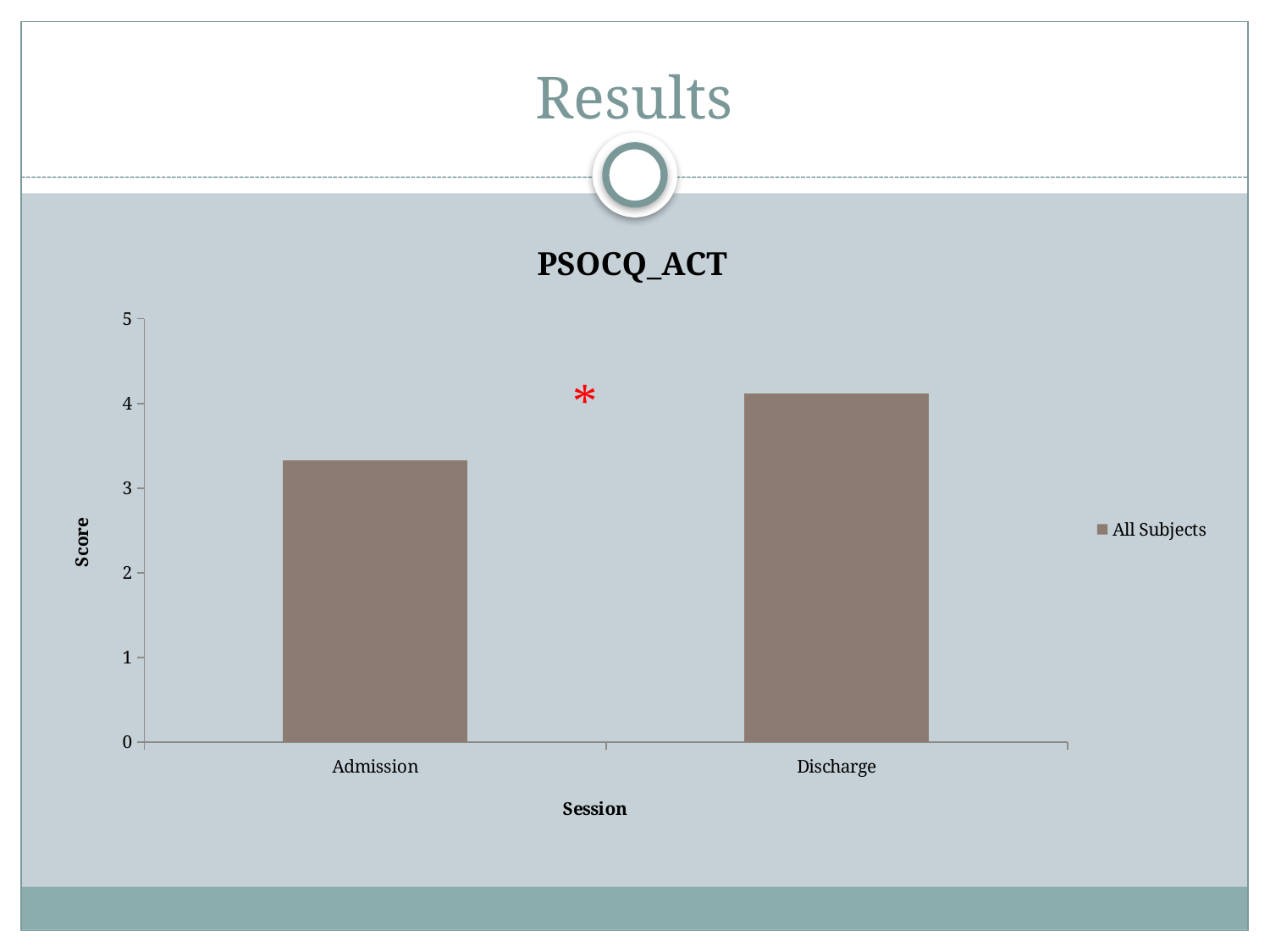
How many series does the legend list? 1 Is the score for Admission greater or less than 4? less Is the score for Discharge greater or less than 4? greater Is the score for Admission greater or less than 3? greater Which session has the highest score? Discharge Which is larger, the score for Admission or for Discharge? Discharge Which session has the lowest score? Admission How many categories are shown on the x axis? 2 Do the scores rise or fall from Admission to Discharge? rise What is the title of the chart? PSOCQ_ACT What is the label of the y axis? Score What type of chart is shown on the slide? bar chart